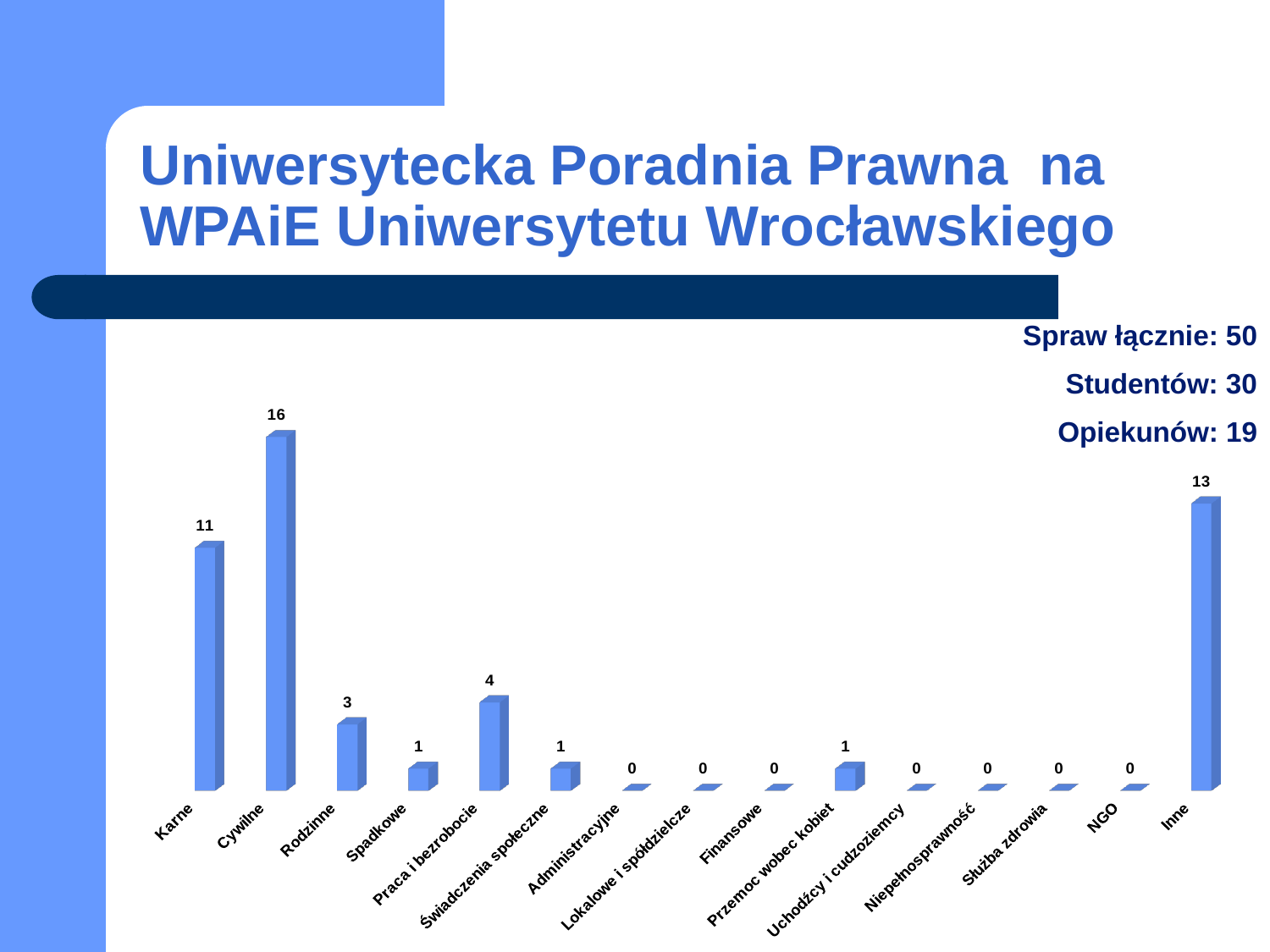
What is the value for Rodzinne? 3 How many categories are shown on the x axis? 15 What is the difference between the values for Karne and Rodzinne? 8 What kind of chart is shown on the slide? Bar chart What is the value for Inne? 13 What is the difference between the values for Cywilne and Inne? 3 What is the value for Przemoc wobec kobiet? 1 Which is larger, the value for Karne or the value for Inne? Inne What is the value for Cywilne? 16 What is the value for Praca i bezrobocie? 4 Which category has the highest value? Cywilne What is the value for Karne? 11